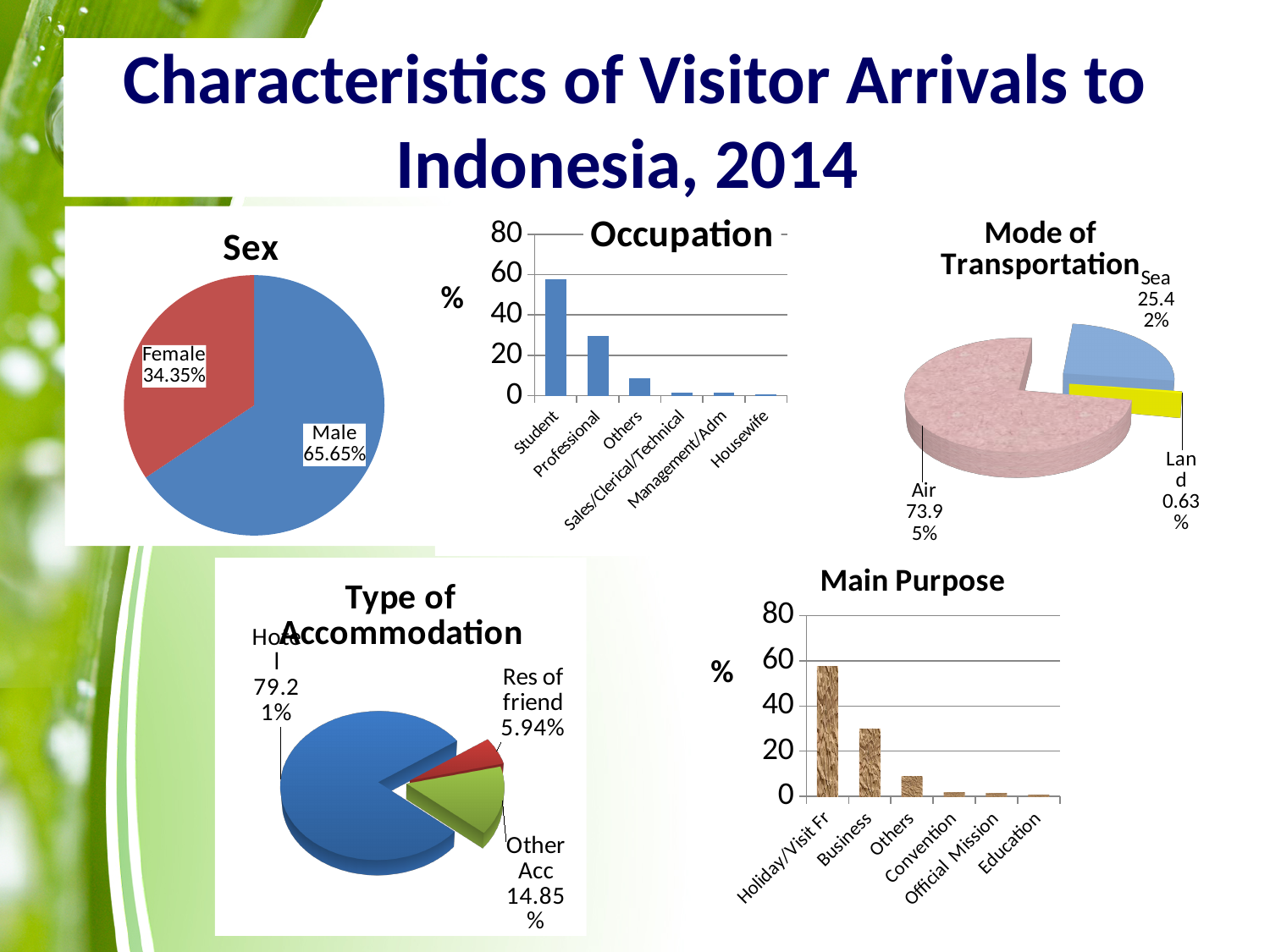
In the Mode of Transportation chart, what percentage of visitors arrived by Air? 73.95% In the Sex chart, what percentage of visitor arrivals were Female? 34.35% In the Main Purpose chart, which purpose has the highest value? Holiday/Visit Fr How many occupation categories are shown in the Occupation chart? 6 In the Mode of Transportation chart, which mode has the smallest share? Land In the Sex chart, which slice is larger, Male or Female? Male In the Sex chart, what percentage of visitor arrivals were Male? 65.65% In the Type of Accommodation chart, what percentage is shown for Other Acc? 14.85% What kind of chart is the Occupation chart? bar chart In the Occupation chart, is the value for Student greater or less than 40? greater In the Main Purpose chart, is the value for Business greater or less than 40? less In the Occupation chart, which occupation has the highest value? Student